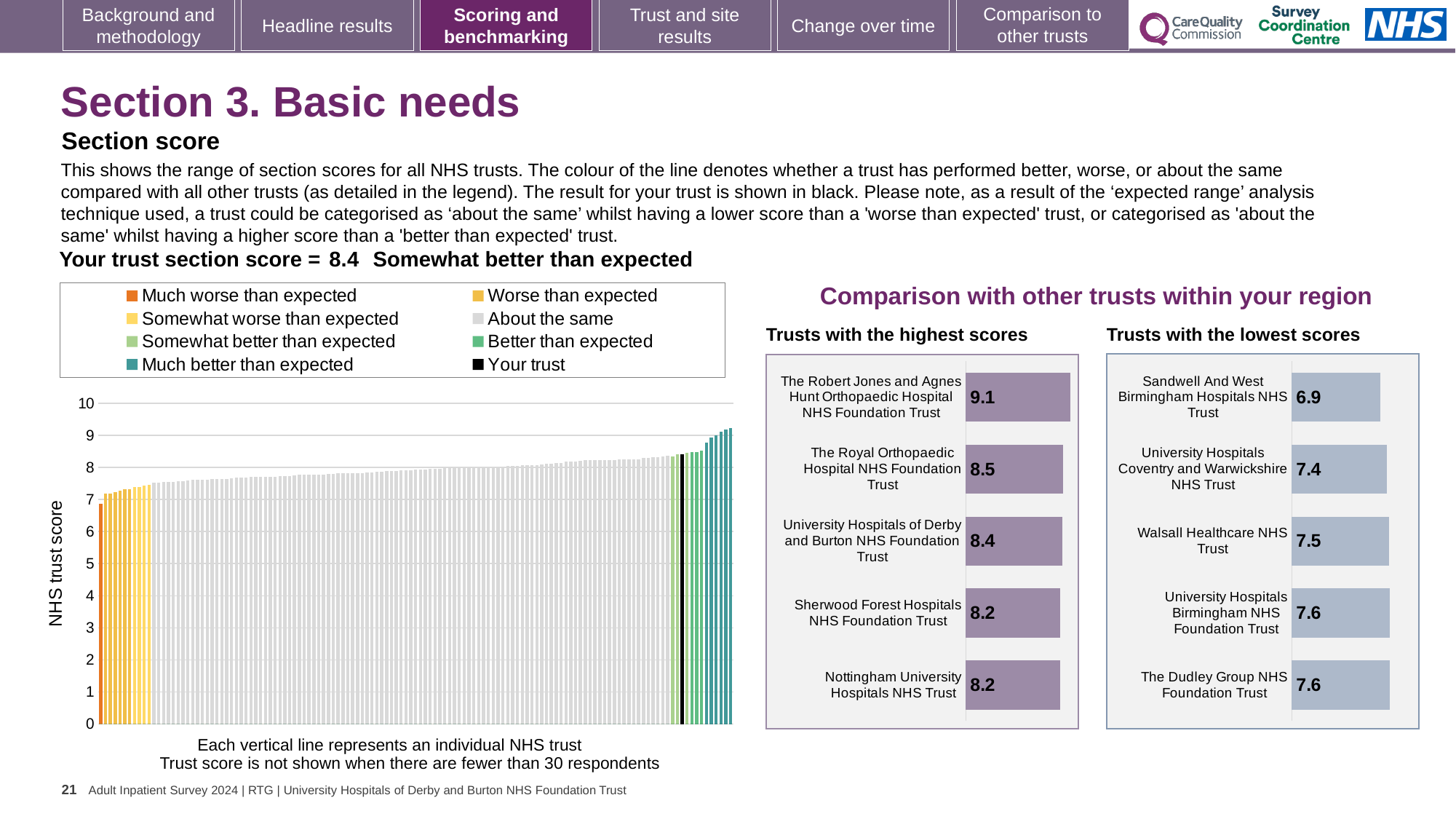
In the large chart on the left, is the value of the tallest bar greater or less than 9? greater In the 'Trusts with the lowest scores' chart, which is larger: the score for University Hospitals Coventry and Warwickshire NHS Trust or the score for The Dudley Group NHS Foundation Trust? The Dudley Group NHS Foundation Trust In the large chart on the left, do the trust scores rise or fall from left to right? Rise In the 'Trusts with the highest scores' chart, what is the score for Sherwood Forest Hospitals NHS Foundation Trust? 8.2 In the 'Trusts with the lowest scores' chart, which trust has the lowest score? Sandwell And West Birmingham Hospitals NHS Trust In the 'Trusts with the highest scores' chart, what is the score for The Robert Jones and Agnes Hunt Orthopaedic Hospital NHS Foundation Trust? 9.1 What type of chart is the large chart on the left showing NHS trust scores? Bar chart How many entries does the legend above the large chart on the left list? 8 In the 'Trusts with the highest scores' chart, what is the difference between the scores of The Robert Jones and Agnes Hunt Orthopaedic Hospital NHS Foundation Trust and The Royal Orthopaedic Hospital NHS Foundation Trust? 0.6 In the 'Trusts with the lowest scores' chart, what is the difference between the scores of University Hospitals Birmingham NHS Foundation Trust and Sandwell And West Birmingham Hospitals NHS Trust? 0.7 In the 'Trusts with the lowest scores' chart, what is the score for Walsall Healthcare NHS Trust? 7.5 How many trusts are shown in the 'Trusts with the highest scores' chart? 5